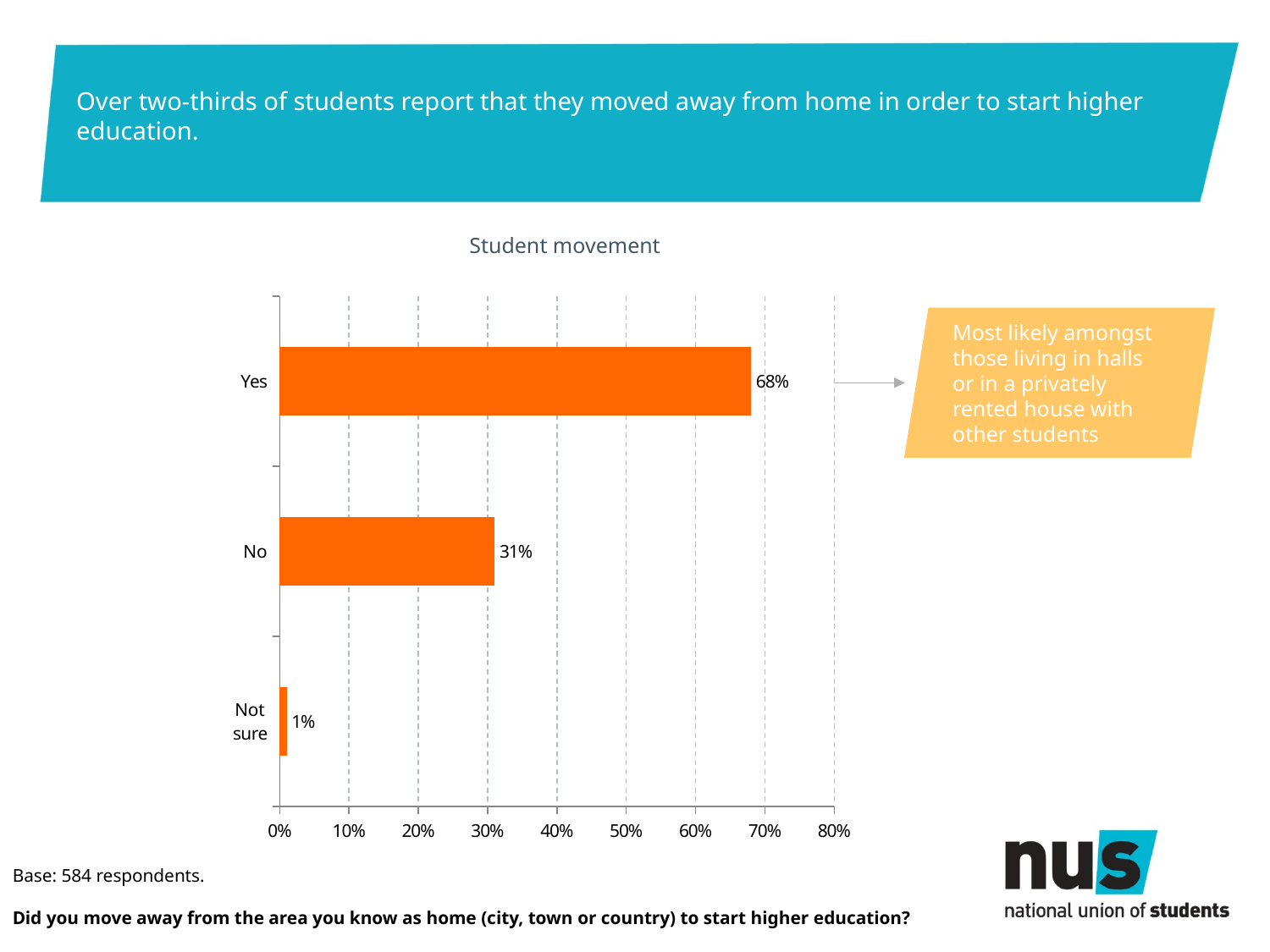
How many categories are shown in the Student movement chart? 3 Is the value for "Yes" in the Student movement chart greater or less than 60%? greater What percentage of students answered "No" in the Student movement chart? 31% What is the title of the chart on the slide? Student movement Which is larger in the Student movement chart, the value for "No" or the value for "Not sure"? No What is the difference between the "Yes" and "No" values in the Student movement chart? 37% What is the highest value shown on the x axis of the Student movement chart? 80% What percentage of students answered "Not sure" in the Student movement chart? 1% What percentage of students answered "Yes" in the Student movement chart? 68% Which category has the highest value in the Student movement chart? Yes Which category has the lowest value in the Student movement chart? Not sure What kind of chart is the Student movement chart? Bar chart